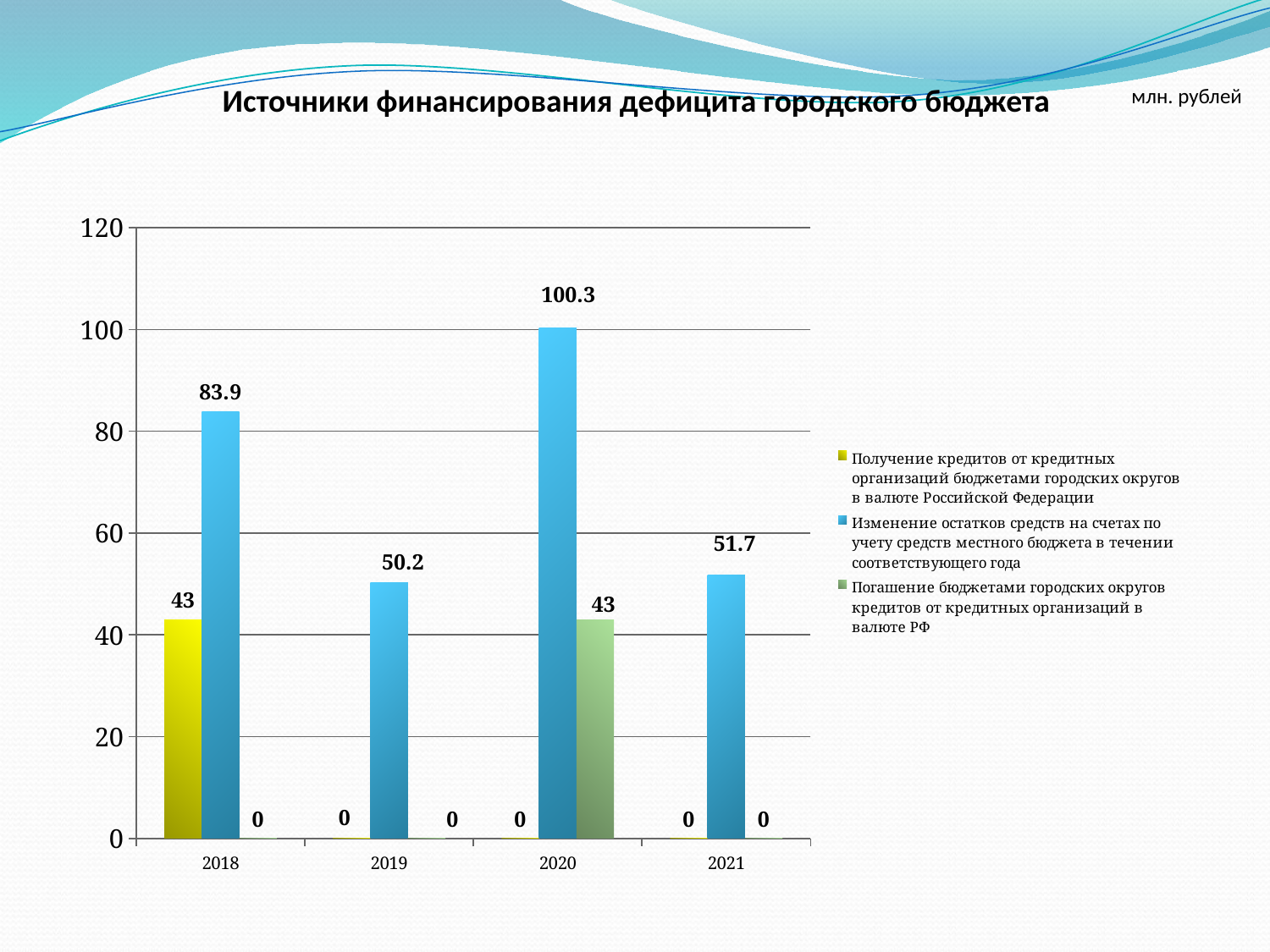
Which is larger: the 2021 or the 2019 value of the series 'Изменение остатков средств на счетах по учету средств местного бюджета в течении соответствующего года'? 2021 What is the value of the series 'Получение кредитов от кредитных организаций бюджетами городских округов в валюте Российской Федерации' for 2018? 43 What unit of measurement is indicated for the chart? млн. рублей What is the value of the series 'Изменение остатков средств на счетах по учету средств местного бюджета в течении соответствующего года' for 2019? 50.2 What is the value of the series 'Изменение остатков средств на счетах по учету средств местного бюджета в течении соответствующего года' for 2020? 100.3 In which year is the value of the series 'Изменение остатков средств на счетах по учету средств местного бюджета в течении соответствующего года' the lowest? 2019 How many series does the legend list? 3 What type of chart is shown on the slide? bar chart What is the value of the series 'Погашение бюджетами городских округов кредитов от кредитных организаций в валюте РФ' for 2020? 43 In which year is the value of the series 'Изменение остатков средств на счетах по учету средств местного бюджета в течении соответствующего года' the highest? 2020 What is the difference between the 2020 and 2018 values of the series 'Изменение остатков средств на счетах по учету средств местного бюджета в течении соответствующего года'? 16.4 How many years are shown on the x axis of the chart? 4